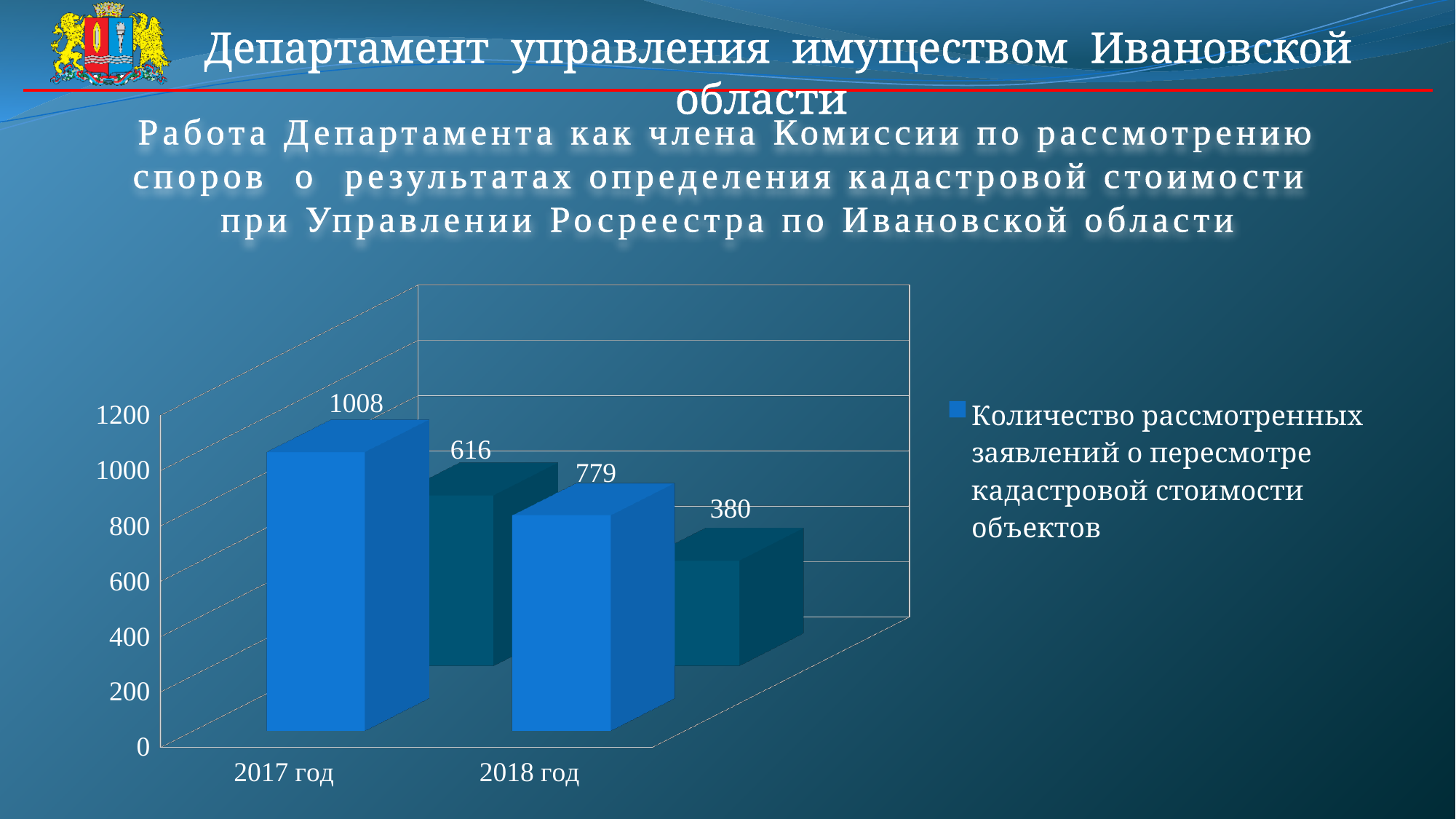
What is the difference between the 2017 год and 2018 год values for 'Количество рассмотренных заявлений о пересмотре кадастровой стоимости объектов'? 229 What kind of chart is shown on the slide? bar chart Is the value for 2018 год of 'Количество рассмотренных заявлений о пересмотре кадастровой стоимости объектов' greater or less than 1000? less How many years are shown on the x axis of the chart? 2 What is the value of 'Количество рассмотренных заявлений о пересмотре кадастровой стоимости объектов' for 2018 год? 779 Does the value of 'Количество рассмотренных заявлений о пересмотре кадастровой стоимости объектов' rise or fall from 2017 год to 2018 год? fall What value is labelled on the darker bar for 2017 год? 616 What value is labelled on the darker bar for 2018 год? 380 Which is larger: the darker bar for 2017 год or the darker bar for 2018 год? 2017 год Which year has the higher value for 'Количество рассмотренных заявлений о пересмотре кадастровой стоимости объектов'? 2017 год What is the value of 'Количество рассмотренных заявлений о пересмотре кадастровой стоимости объектов' for 2017 год? 1008 What is the difference between the two labelled values for 2017 год (1008 and 616)? 392